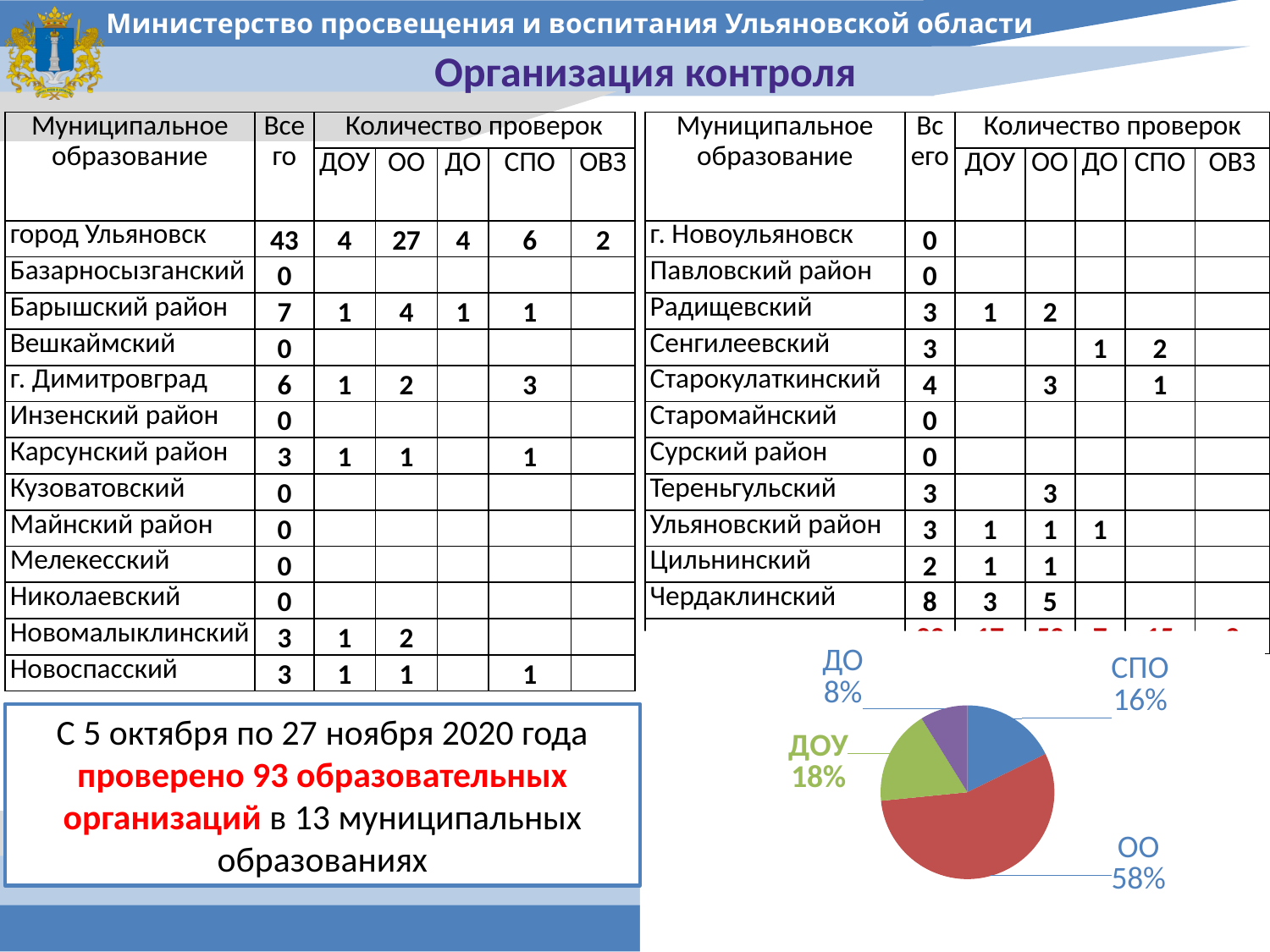
Which slice of the pie chart is the smallest? ДО In the pie chart, what share does СПО have? 16% In the pie chart, what is the difference in percentage points between ОО and ДОУ? 40 What colour is the ОО slice in the pie chart? red In the pie chart, what share does ДО have? 8% Which slice of the pie chart is the largest? ОО In the pie chart, what share does ДОУ have? 18% What kind of chart is shown at the bottom right of the slide? pie chart In the pie chart, what is the difference in percentage points between СПО and ДО? 8 In the pie chart, which is larger, ДОУ or СПО? ДОУ How many slices does the pie chart have? 4